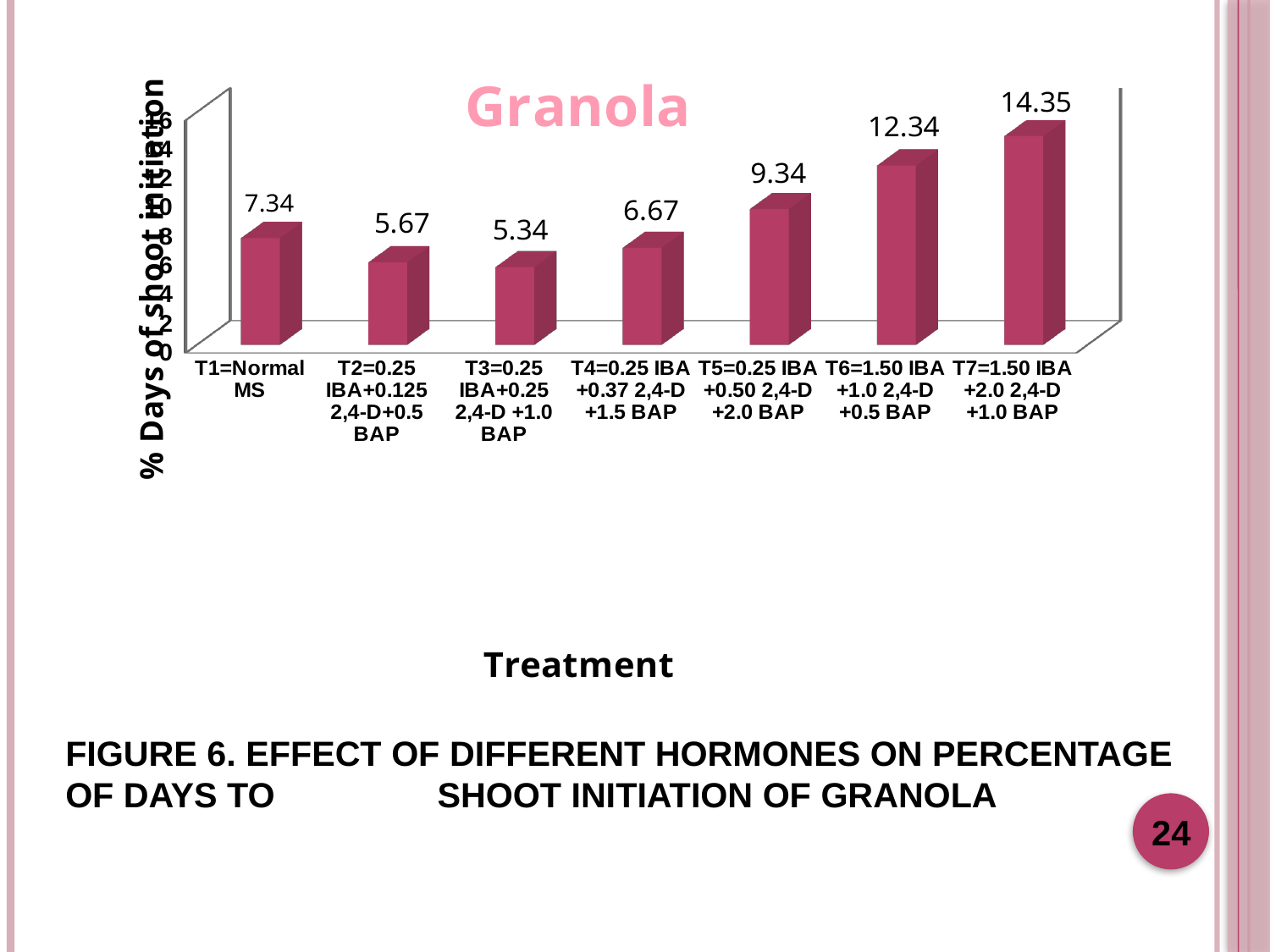
How many treatments are shown on the x axis? 7 What is the title of the chart? Granola Which treatment has the highest value? T7=1.50 IBA +2.0 2,4-D +1.0 BAP What is the value for T7=1.50 IBA +2.0 2,4-D +1.0 BAP? 14.35 What is the difference between the values for T1 and T2? 1.67 What kind of chart is shown? bar chart Is the value for T6 greater or less than 10? greater What is the value for T1=Normal MS? 7.34 Which treatment has the lowest value? T3=0.25 IBA+0.25 2,4-D +1.0 BAP Which is larger, the value for T4 or the value for T1? T1 What is the difference between the values for T7 and T6? 2.01 What is the value for T5=0.25 IBA +0.50 2,4-D +2.0 BAP? 9.34